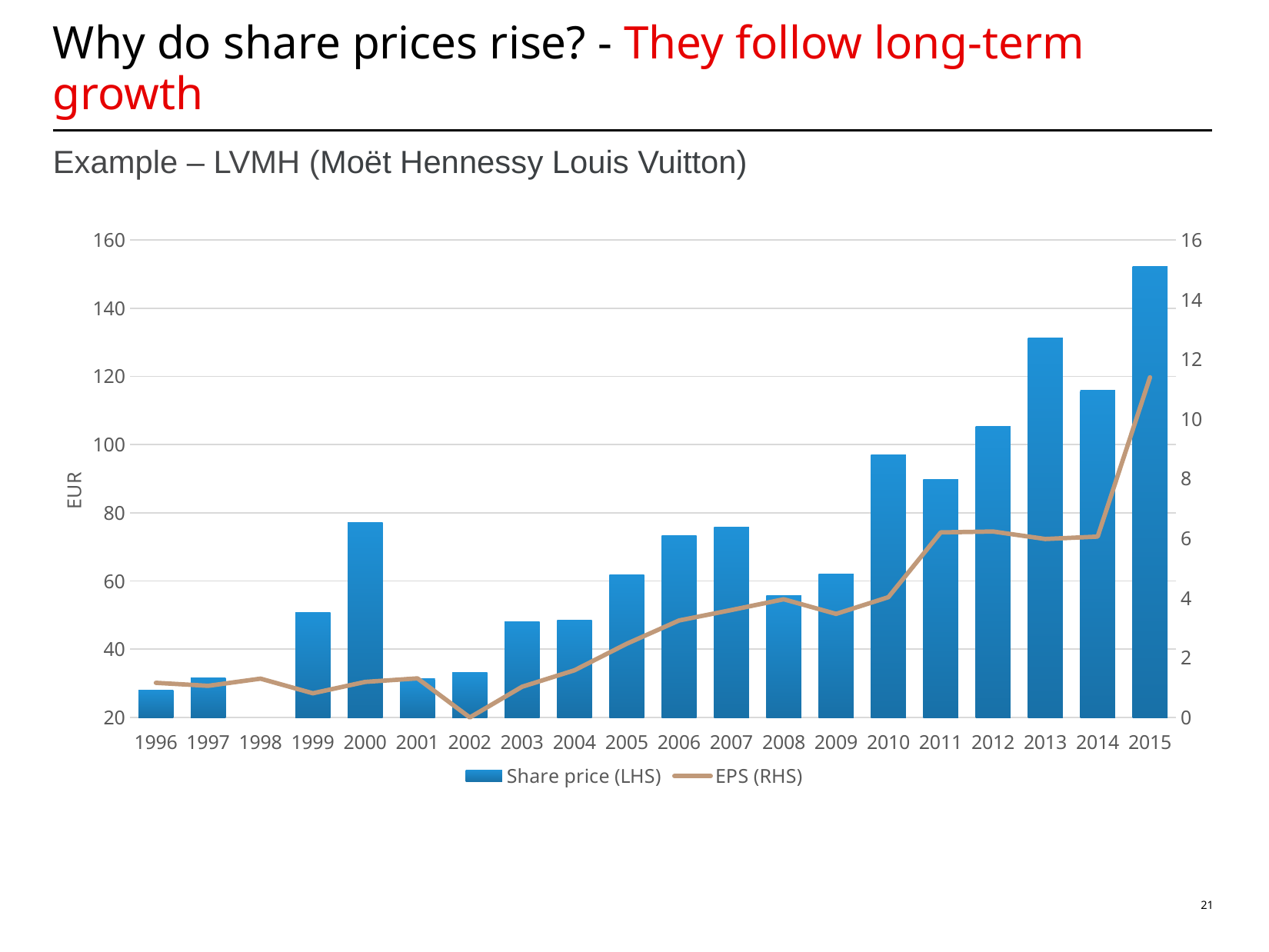
Which year has the larger share price (LHS) bar, 2000 or 2001? 2000 Which year has the highest share price (LHS) bar? 2015 How many years are shown on the x axis? 20 In which year is the EPS (RHS) line at its lowest point? 2002 Is the share price (LHS) for 2015 greater or less than 140? greater Is the share price (LHS) for 2010 greater or less than 80? greater What kind of chart is shown on the slide? A combined bar and line chart Is the share price (LHS) for 2013 greater or less than 120? greater Which year has the larger share price (LHS) bar, 2013 or 2014? 2013 What is the label on the left vertical axis? EUR How many series does the legend list? 2